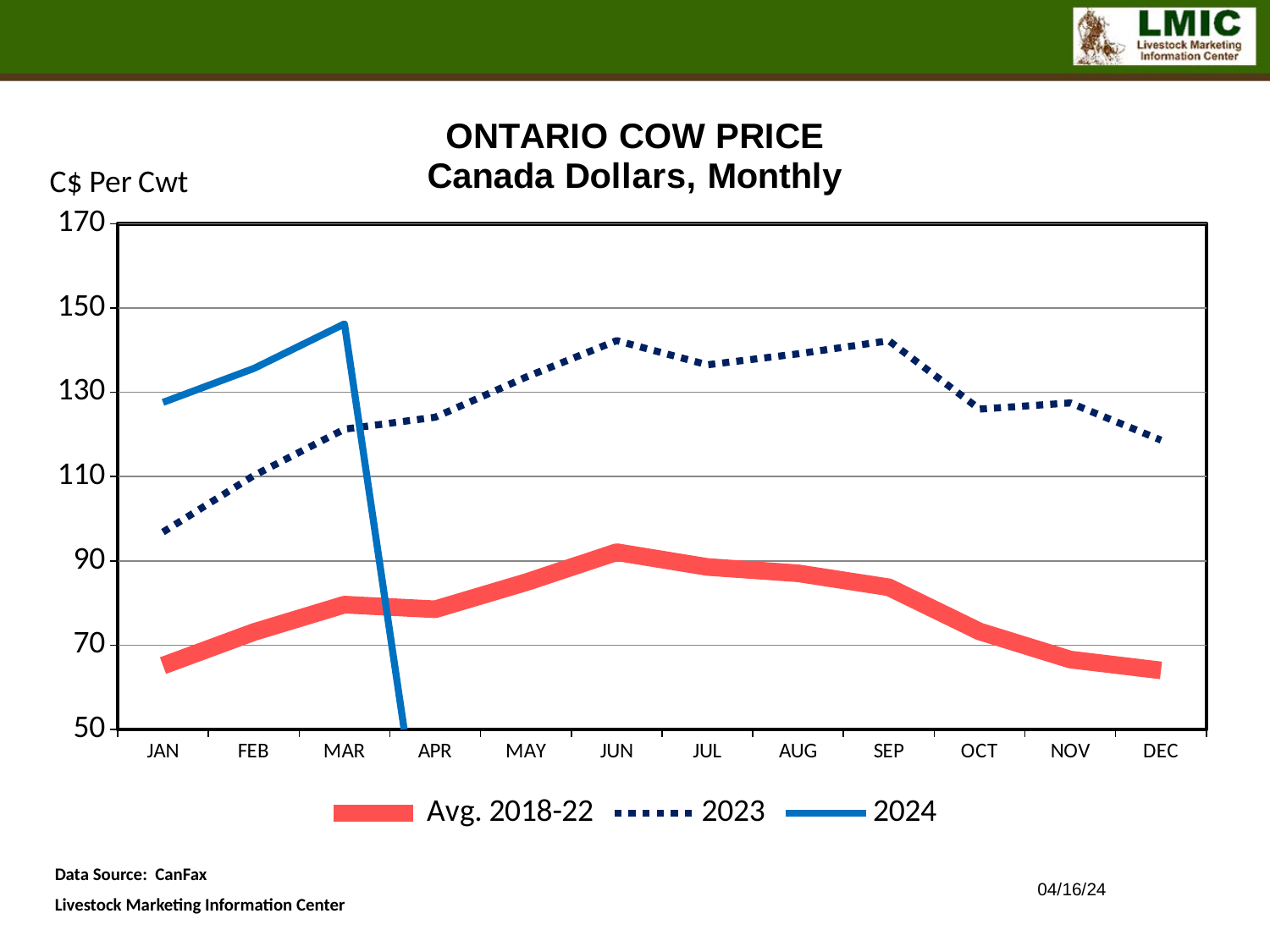
Is the 2024 value for MAR greater or less than 150? less In which month is the 2023 series at its lowest? JAN How many months are shown along the x axis? 12 What is the label on the y axis? C$ Per Cwt Is the Avg. 2018-22 value for JAN greater or less than 70? less Is the 2023 value for JAN greater or less than 110? less Does the 2024 line rise or fall from JAN to MAR? rise How many series does the legend list? 3 In MAR, which series has the higher value, 2023 or 2024? 2024 In which month is the Avg. 2018-22 series at its highest? JUN What kind of chart is shown on the slide? line chart